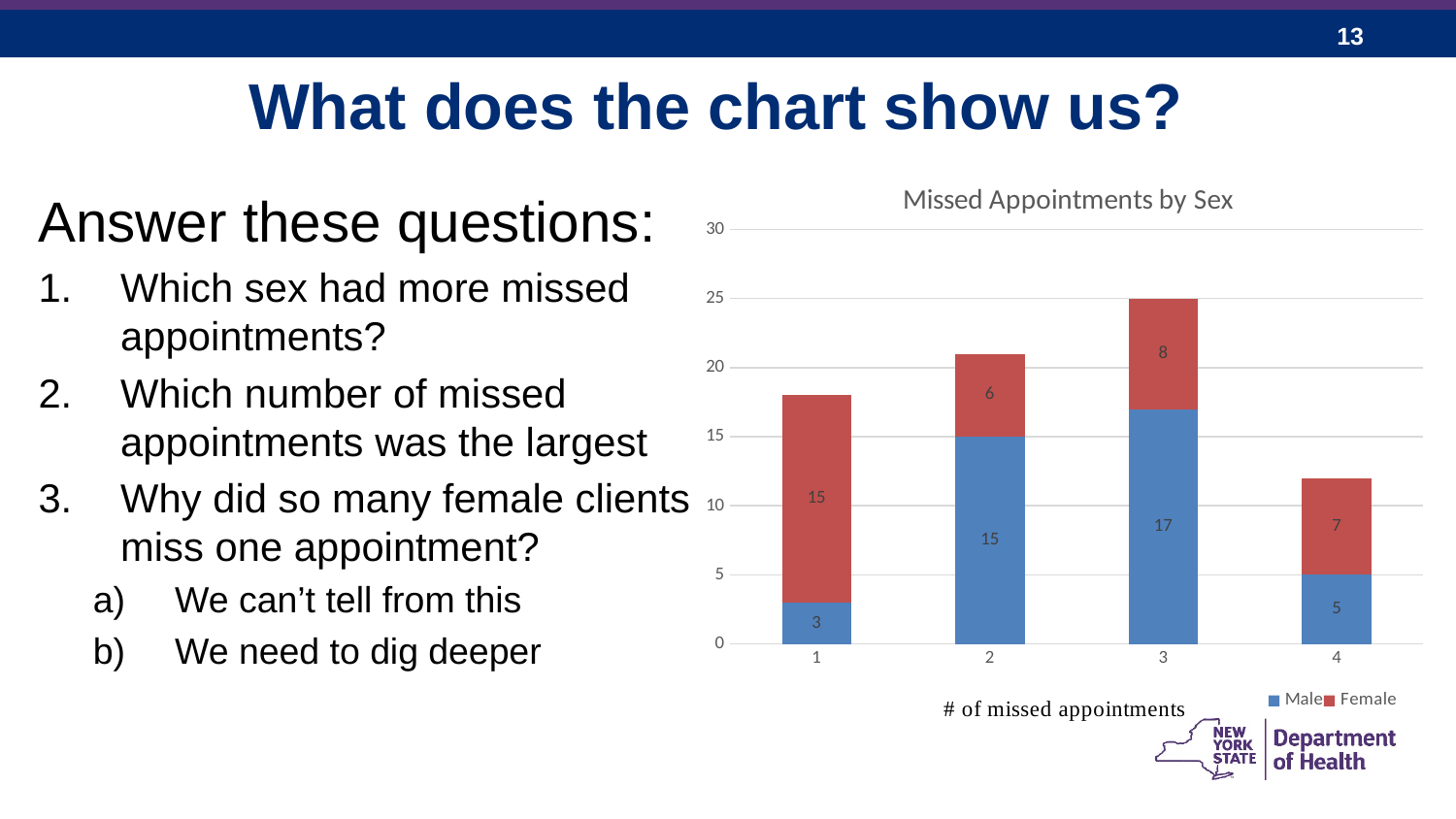
For category 2, which is larger, the Male value or the Female value? Male What type of chart is shown on the slide? Stacked bar chart What is the difference between the Female and Male values for category 1? 12 How many series does the chart legend list? 2 What is the Male value for category 1? 3 How many categories are shown on the x axis of the chart? 4 What is the title of the chart? Missed Appointments by Sex Which category has the highest Male value? 3 What is the Male value for category 4? 5 Which category has the lowest Female value? 2 What is the total of the stacked bar for category 3? 25 What is the Female value for category 3? 8